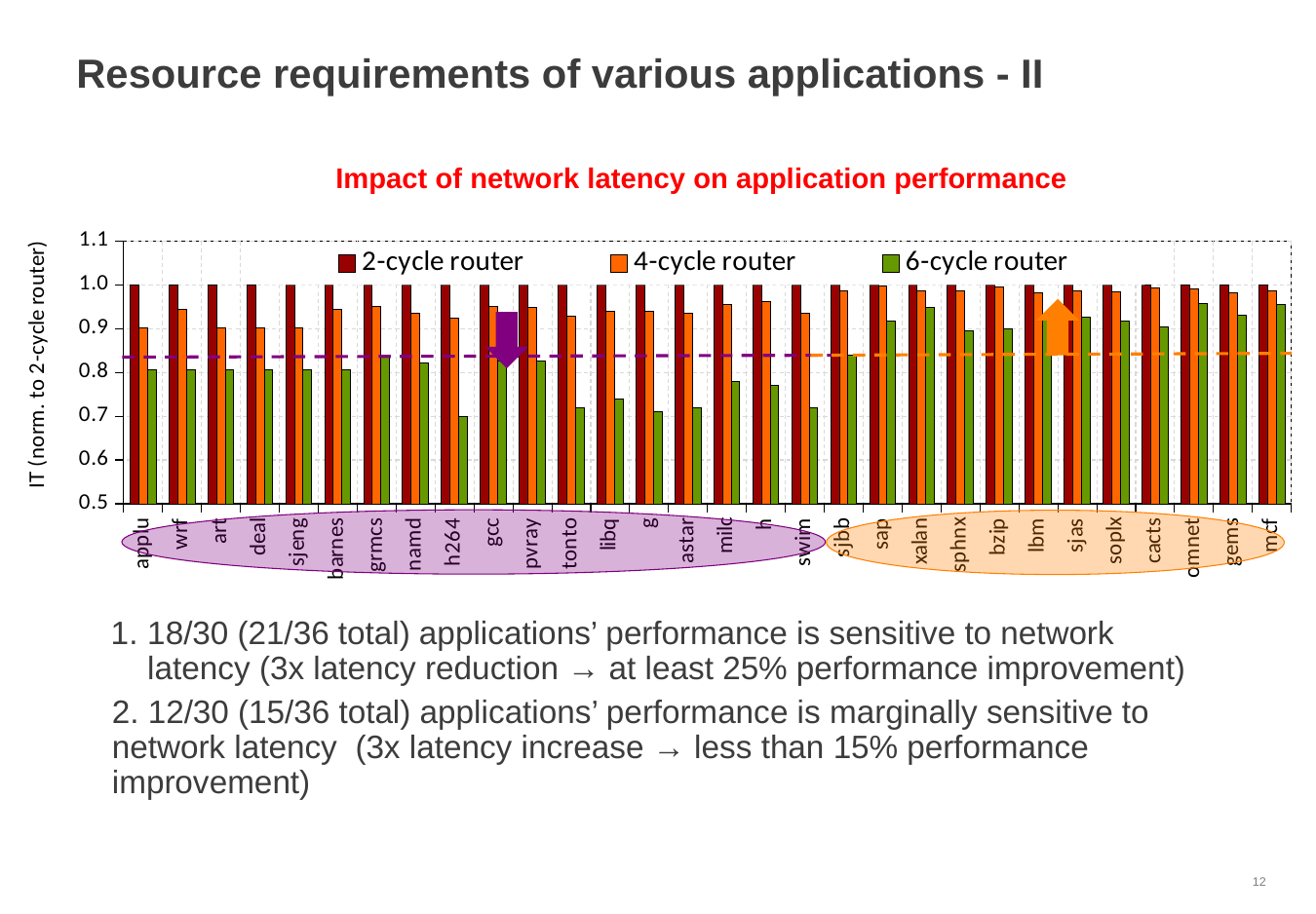
Which has the larger 4-cycle router value, applu or sjbb? sjbb What kind of chart is shown on the slide? bar chart Is the 6-cycle router value for h264 greater or less than 0.8? less Is the 4-cycle router value for wrf greater or less than 0.9? greater Which series is drawn in green in the chart? 6-cycle router How many applications (categories) are plotted along the x axis of the chart? 30 Is the 6-cycle router value for mcf greater or less than 0.9? greater How many series does the chart legend list? 3 What is the value of the 2-cycle router bar for applu? 1.0 Which has the larger 6-cycle router value, h264 or mcf? mcf What is the title of the chart? Impact of network latency on application performance